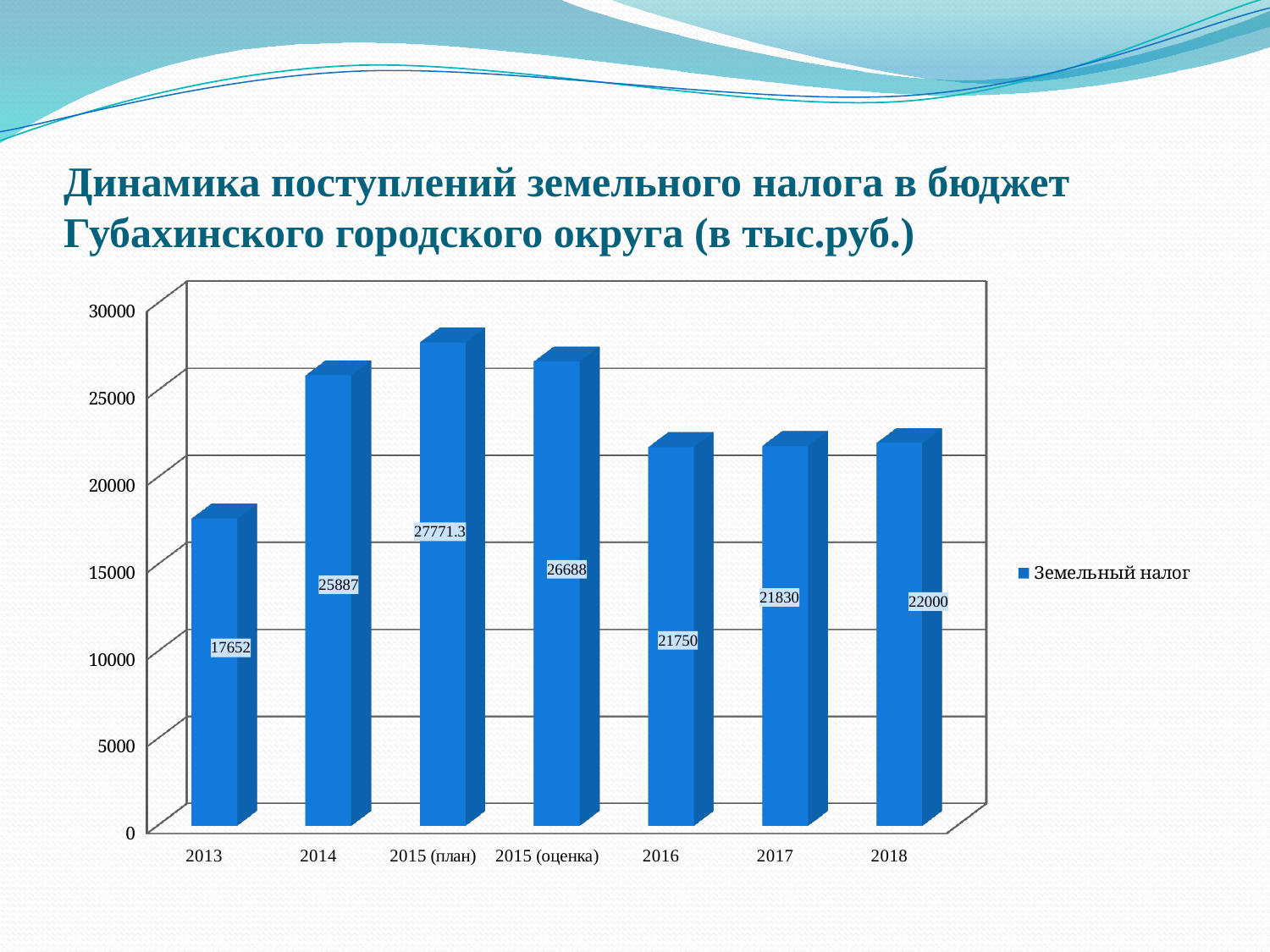
What is the value for 2013? 17652 What is the value for 2015 (план)? 27771.3 How many categories are shown on the x axis? 7 Which category has the highest value? 2015 (план) Which is larger, the value for 2015 (план) or 2015 (оценка)? 2015 (план) Is the value for 2016 greater or less than 20000? greater What is the difference between the values for 2014 and 2013? 8235 What kind of chart is shown on the slide? bar chart What is the value for 2017? 21830 What series name does the legend list? Земельный налог What is the difference between the values for 2018 and 2016? 250 Which category has the lowest value? 2013